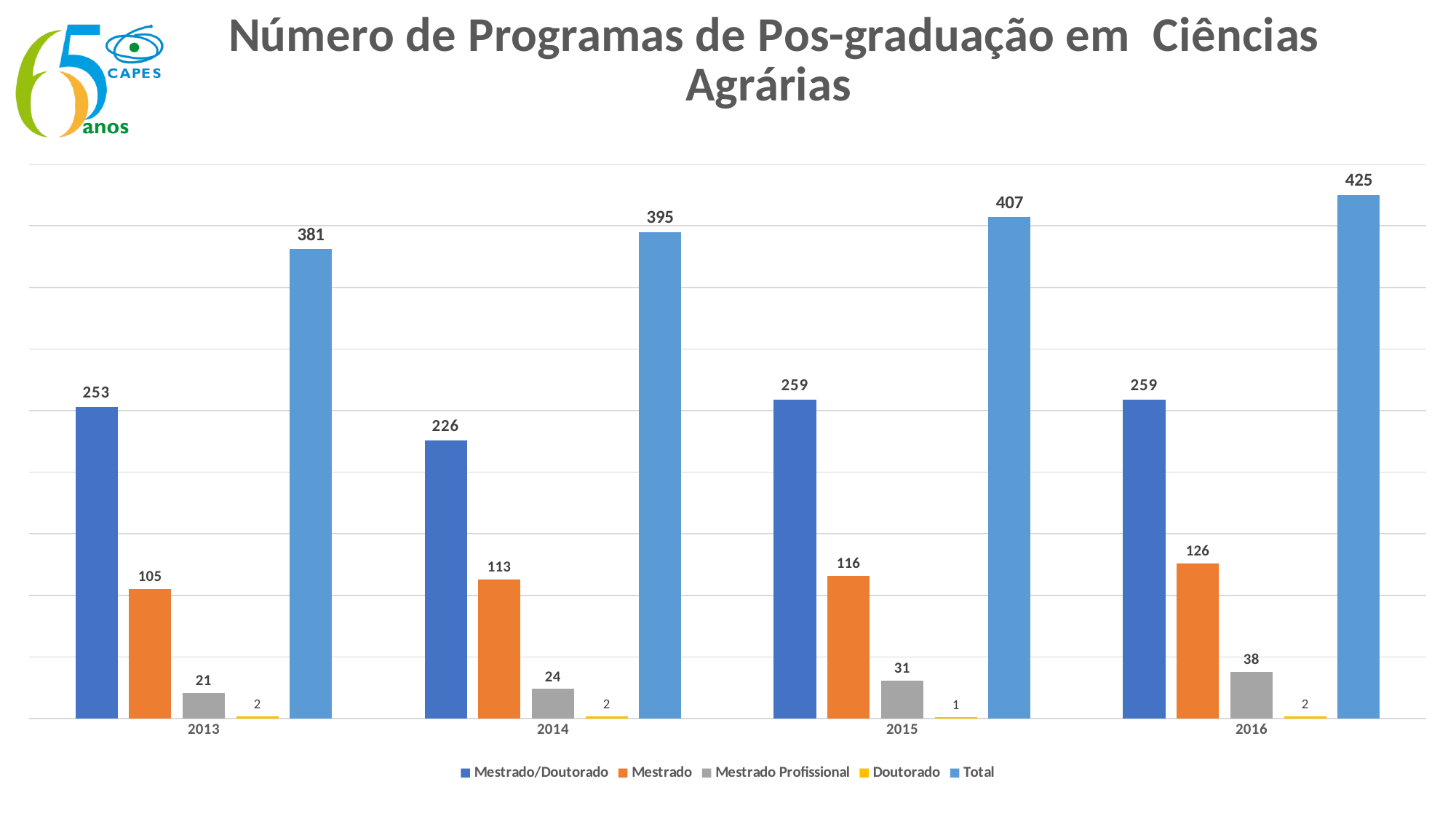
How many years are shown on the x axis? 4 What is the value of Mestrado Profissional for 2015? 31 What is the value of Doutorado for 2015? 1 In which year is Mestrado/Doutorado lowest? 2014 How many series does the legend list? 5 What is the value of Mestrado for 2014? 113 In which year is the Total highest? 2016 Does the Total rise or fall from 2013 to 2016? rise What is the difference between the Total for 2016 and the Total for 2013? 44 Which is larger, Mestrado in 2016 or Mestrado in 2013? Mestrado in 2016 What kind of chart is this? bar chart What is the value of Total for 2016? 425